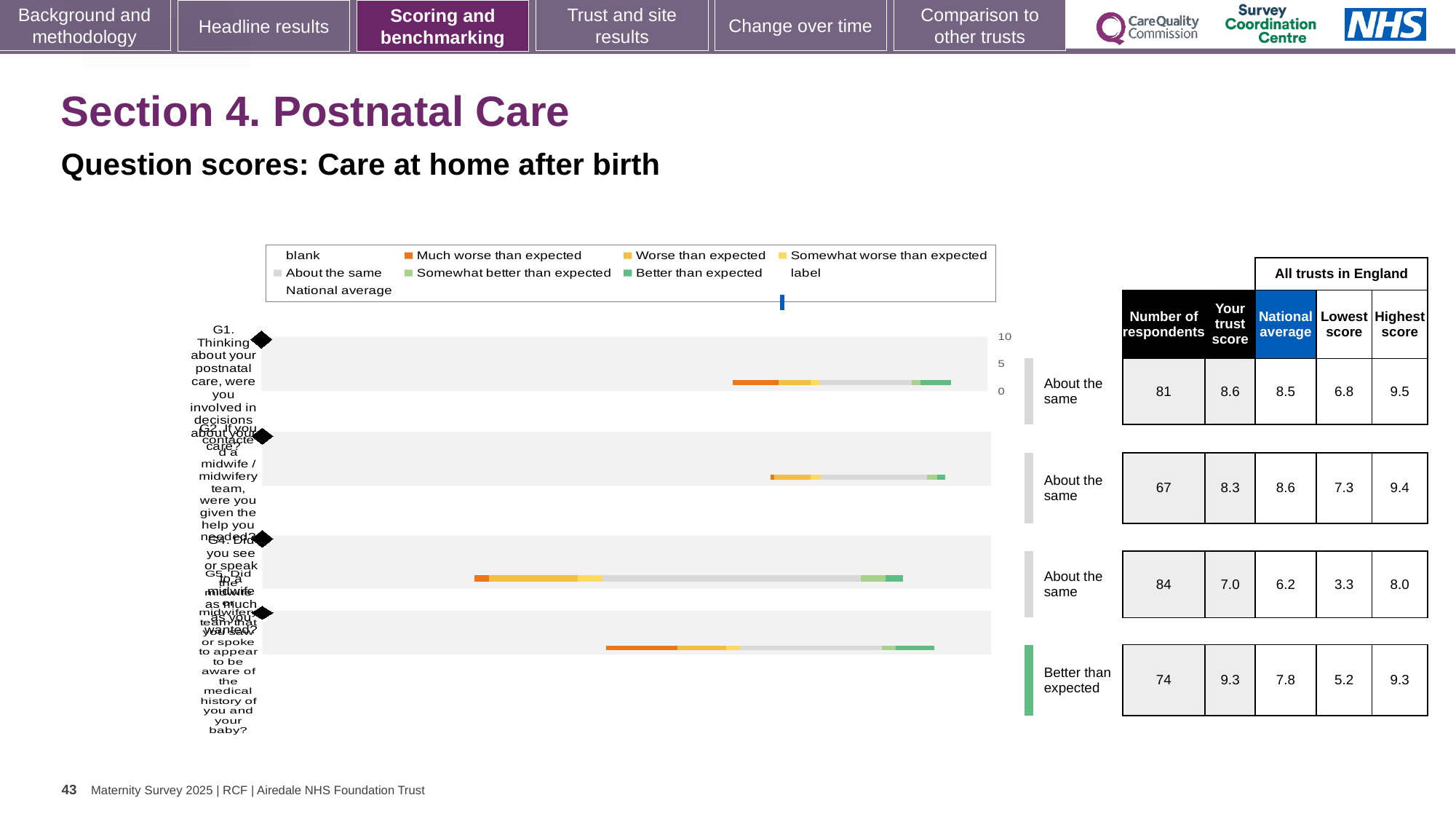
Which question has the lowest trust score? G4 What benchmark category is shown for question G5? Better than expected What is the number of respondents for question G1? 81 What is the title of the chart section on the slide? Question scores: Care at home after birth Is the trust score for question G2 higher or lower than the national average for G2? lower How many question rows (G1, G2, G4, G5) are plotted in the chart? 4 What kind of chart is shown on the slide? bar chart Which question has the highest trust score? G5 What is the lowest score across all trusts in England for question G2? 7.3 What is the trust score for question G4? 7.0 What is the national average for question G5? 7.8 What is the difference between the trust score and the national average for question G4? 0.8